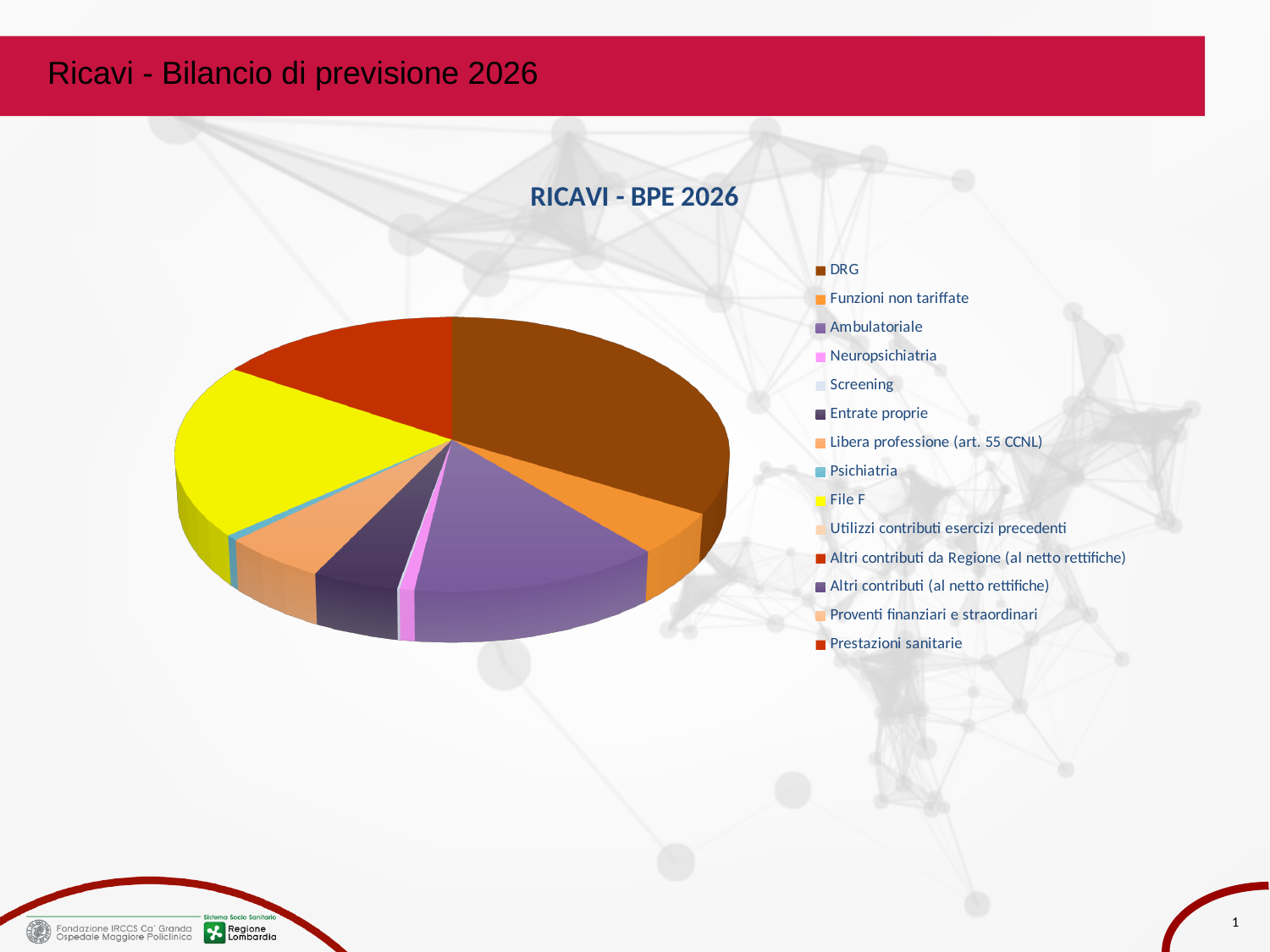
Which slice is larger, DRG or Altri contributi da Regione (al netto rettifiche)? DRG What kind of chart is shown on the slide? pie chart Which category has the largest slice of the pie? DRG What colour is the File F slice in the chart? yellow Which slice is larger, DRG or File F? DRG Which slice is larger, Ambulatoriale or Psichiatria? Ambulatoriale What is the title of the chart? RICAVI - BPE 2026 How many categories does the chart's legend list? 14